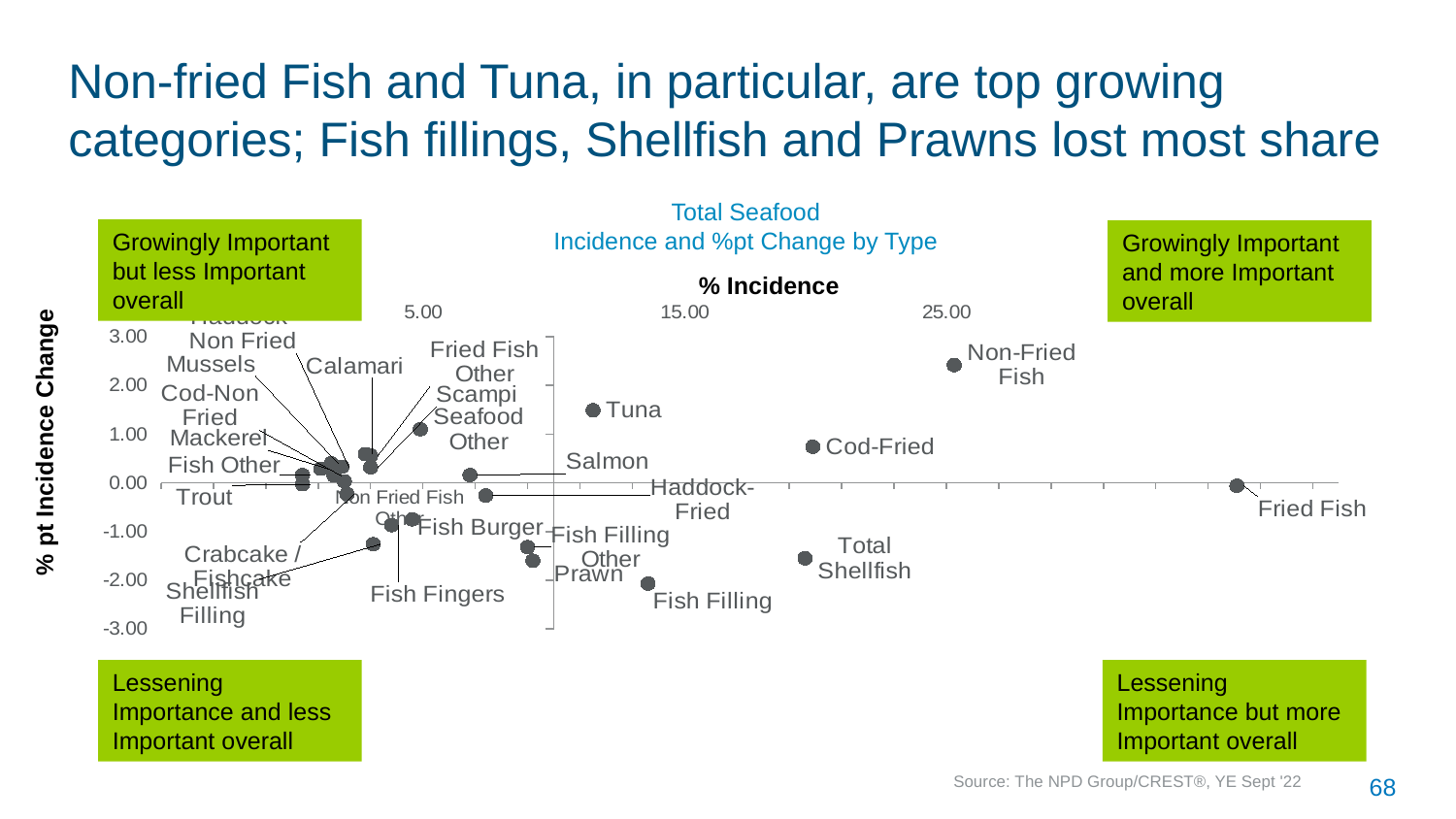
Which has a higher % pt Incidence Change, Non-Fried Fish or Tuna? Non-Fried Fish Is the % pt Incidence Change for Cod-Fried greater or less than 0.00? greater Is the % Incidence for Non-Fried Fish greater or less than 15.00? greater Is the % pt Incidence Change for Total Shellfish greater or less than 0.00? less Which has a higher % Incidence, Fried Fish or Cod-Fried? Fried Fish Which category has the highest % Incidence? Fried Fish What does the green box in the top-right corner of the chart say? Growingly Important and more Important overall What is the title of the chart? Total Seafood Incidence and %pt Change by Type What kind of chart is shown on the slide? Scatter chart Which category has the highest % pt Incidence Change? Non-Fried Fish